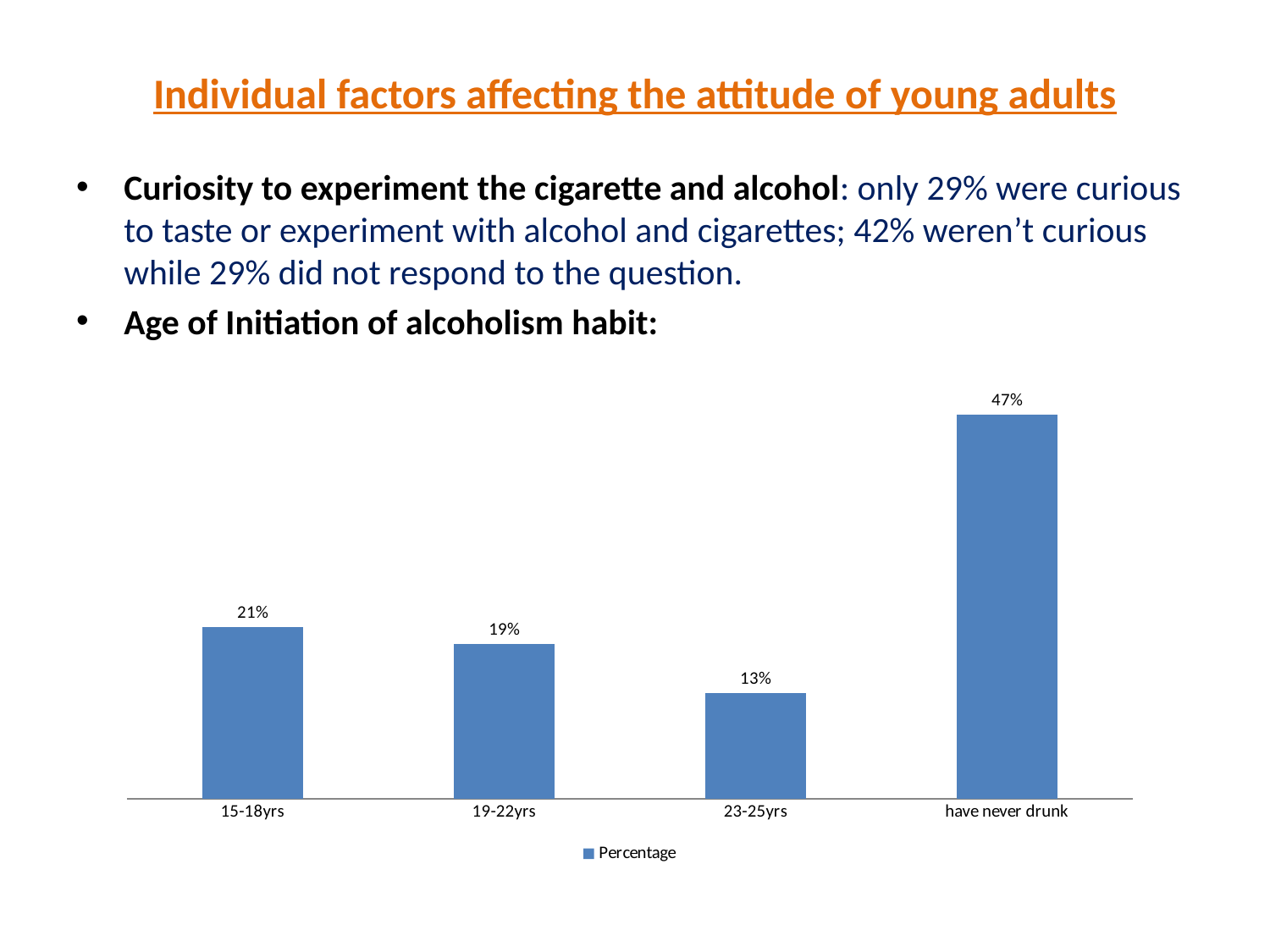
How many categories are shown on the x axis? 4 What is the value for 15-18yrs? 21% What kind of chart is shown on the slide? bar chart What is the value for 19-22yrs? 19% What is the value for 'have never drunk'? 47% How many series does the legend list? 1 Which category has the lowest value? 23-25yrs Which category has the highest value? have never drunk Which is larger, the value for 15-18yrs or the value for 23-25yrs? 15-18yrs What is the difference between the values for 19-22yrs and 23-25yrs? 6% What is the difference between the values for 'have never drunk' and 15-18yrs? 26% What is the value for 23-25yrs? 13%